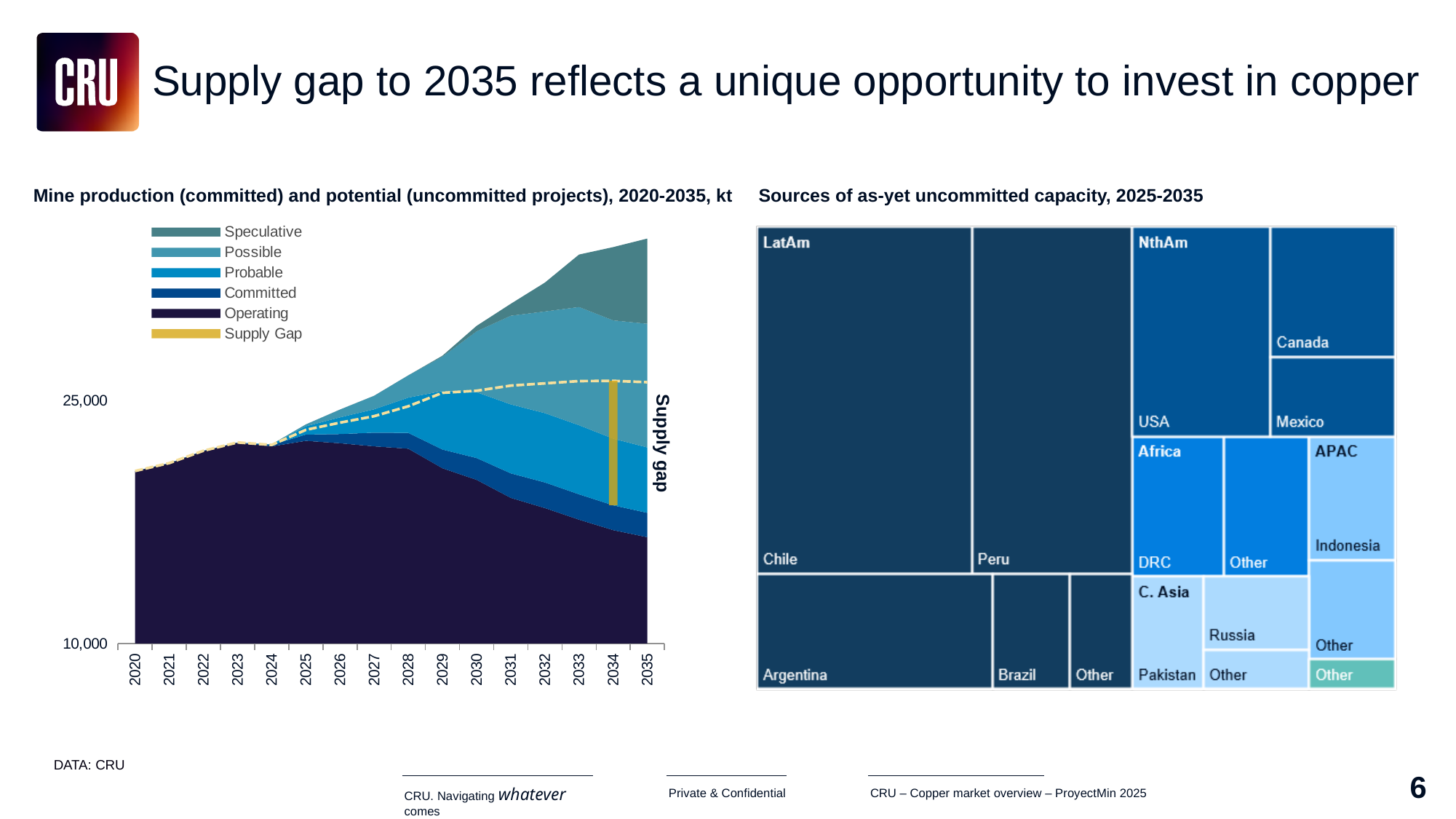
In the left chart, how many years are shown on the x axis? 16 In the right chart, which block is larger, Chile or Peru? Chile What kind of chart is the right chart, 'Sources of as-yet uncommitted capacity, 2025-2035'? Treemap In the left chart, how many series does the legend list? 6 In the right chart, which country has the largest block? Chile In the left chart, is the top of the Operating area in 2035 greater or less than 25,000? less In the left chart, in which year is the Supply Gap bar drawn? 2034 In the left chart, is the total mine production in 2020 greater or less than 25,000? less In the left chart, does the Operating area rise or fall from 2028 to 2035? Falls What kind of chart is the left chart, 'Mine production (committed) and potential (uncommitted projects), 2020-2035, kt'? Combination chart: stacked areas with a dashed line and a bar In the right chart, which block is larger, USA or Canada? USA In the left chart, is the top of the stacked areas (including Speculative) in 2035 greater or less than 25,000? greater